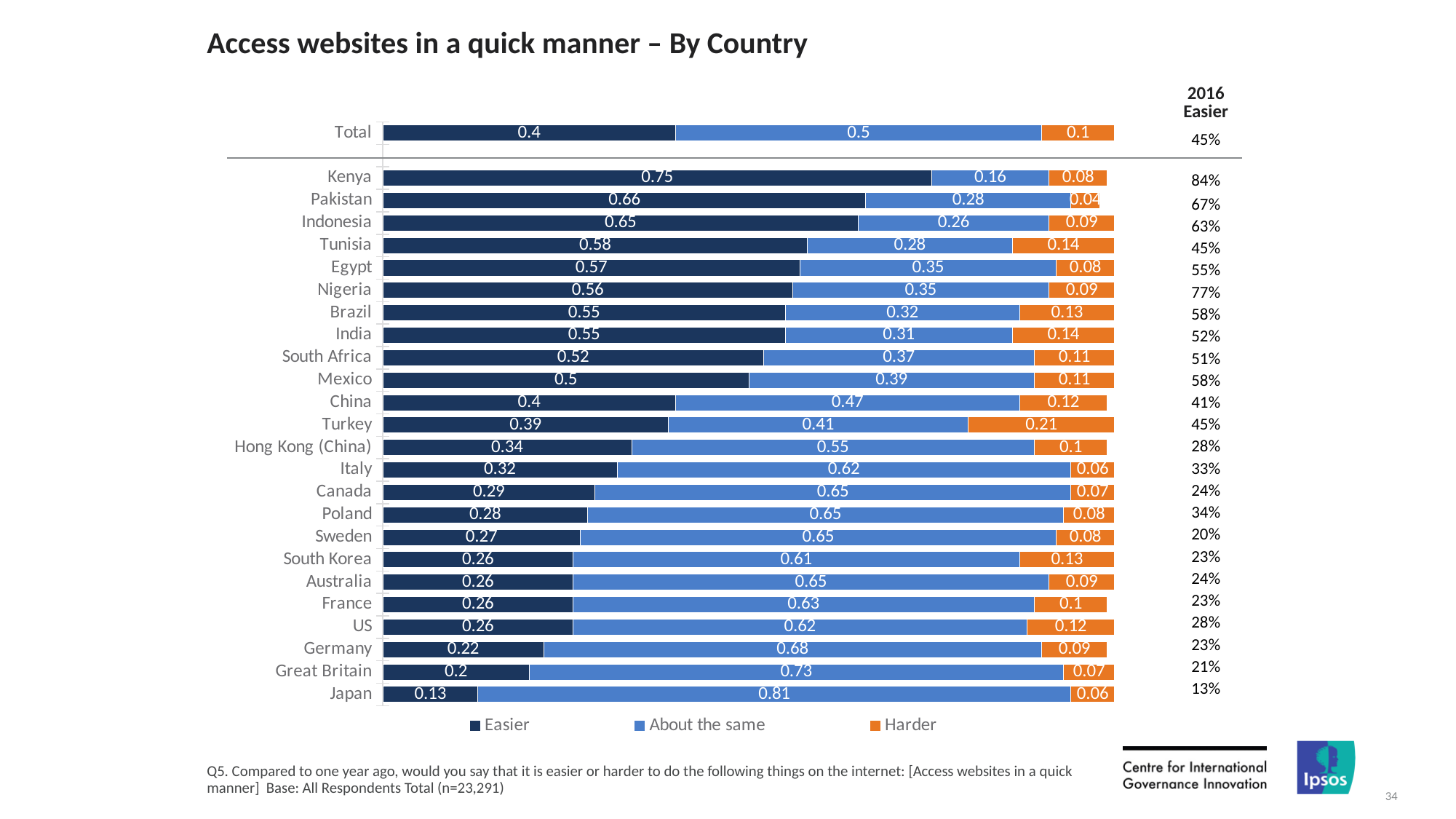
How many countries (excluding Total) are plotted in the chart? 24 Which has the larger 'Harder' value, Turkey or Pakistan? Turkey Which country has the highest 'Harder' value? Turkey What is the total of the stacked bar for Kenya? 0.99 What is the 'Harder' value for Turkey? 0.21 Which country has the lowest 'Easier' value? Japan What is the 'Easier' value for Kenya? 0.75 What is the difference between the 'Easier' values for Kenya and Japan? 0.62 How many series does the legend list? 3 Which country has the highest 'Easier' value? Kenya What kind of chart is shown on the slide? Stacked bar chart What is the 'About the same' value for Japan? 0.81